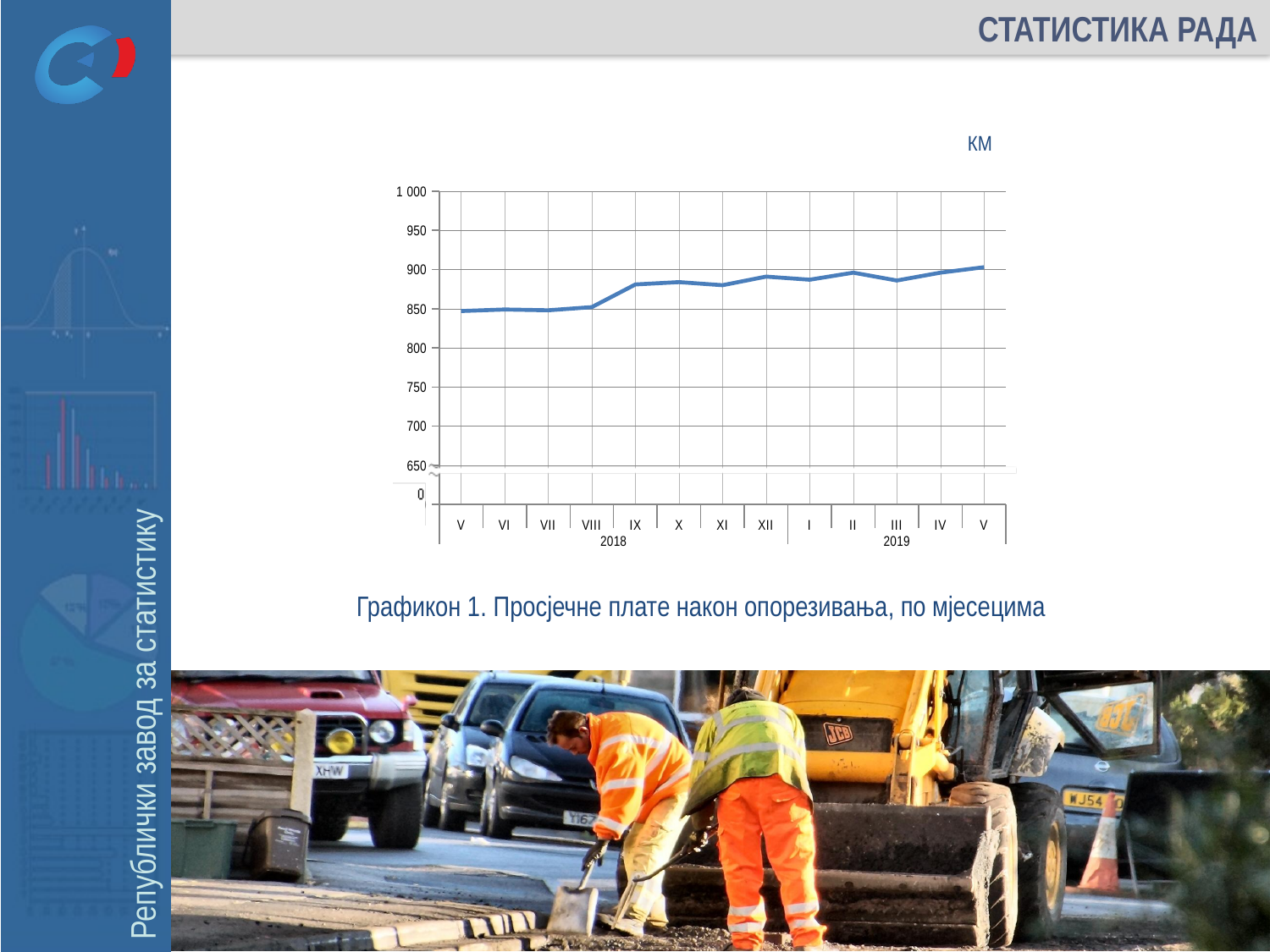
Is the value for V 2018 greater or less than 900? less Do the values generally rise or fall from V 2018 to V 2019? rise What unit is indicated above the chart? KM What is the caption of the chart? Графикон 1. Просјечне плате након опорезивања, по мјесецима Which is larger, the value for V 2018 or the value for V 2019? V 2019 How many monthly data points are plotted on the chart? 13 Is the value for VII 2018 greater or less than 900? less Is the value for IX 2018 greater or less than 850? greater What kind of chart is shown on the slide? line chart Which is larger, the value for VI 2018 or the value for XII 2018? XII 2018 Which is larger, the value for VIII 2018 or the value for IX 2018? IX 2018